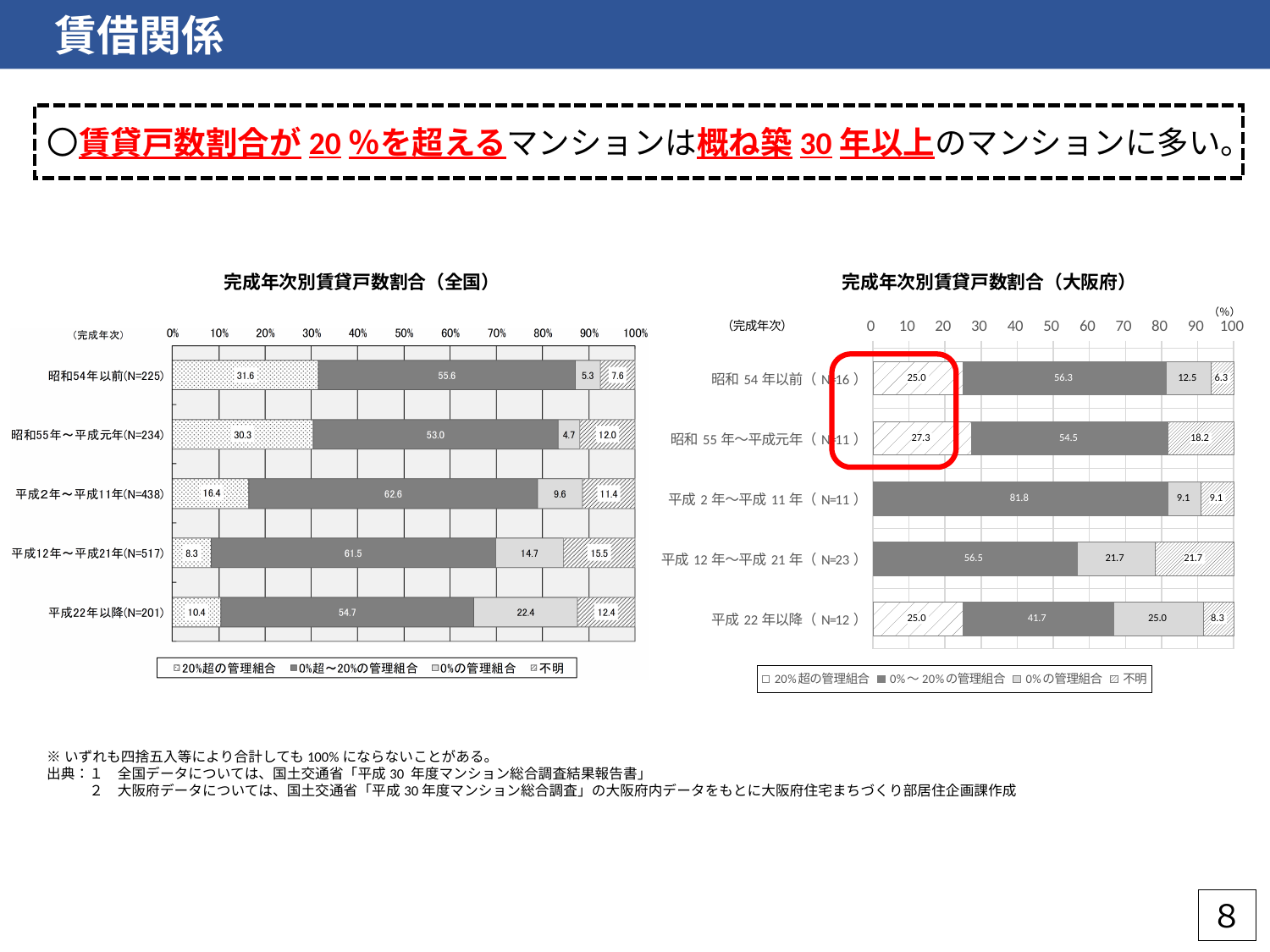
In the chart titled 完成年次別賃貸戸数割合（大阪府）, what is the value of 20%超の管理組合 for 昭和55年～平成元年(N=11)? 27.3 What type of chart is the chart titled 完成年次別賃貸戸数割合（大阪府）? Stacked bar chart In the chart titled 完成年次別賃貸戸数割合（全国）, what is the difference between the 0%の管理組合 values for 平成22年以降(N=201) and 昭和54年以前(N=225)? 17.1 In the chart titled 完成年次別賃貸戸数割合（大阪府）, how many categories (completion-year groups) are shown? 5 In the chart titled 完成年次別賃貸戸数割合（大阪府）, what is the value of 0%超～20%の管理組合 for 平成2年～平成11年(N=11)? 81.8 In the chart titled 完成年次別賃貸戸数割合（大阪府）, what is the difference between the 0%超～20%の管理組合 values for 平成2年～平成11年(N=11) and 平成22年以降(N=12)? 40.1 In the chart titled 完成年次別賃貸戸数割合（全国）, how many series does the legend list? 4 In the chart titled 完成年次別賃貸戸数割合（全国）, what is the value of 0%超～20%の管理組合 for 平成2年～平成11年(N=438)? 62.6 In the chart titled 完成年次別賃貸戸数割合（全国）, which category has the highest value for 20%超の管理組合? 昭和54年以前(N=225) In the chart titled 完成年次別賃貸戸数割合（全国）, what is the value of 20%超の管理組合 for 昭和54年以前(N=225)? 31.6 In the chart titled 完成年次別賃貸戸数割合（大阪府）, which is larger: the 不明 value for 平成12年～平成21年(N=23) or for 昭和54年以前(N=16)? 平成12年～平成21年(N=23) In the chart titled 完成年次別賃貸戸数割合（全国）, which category has the lowest value for 20%超の管理組合? 平成12年～平成21年(N=517)